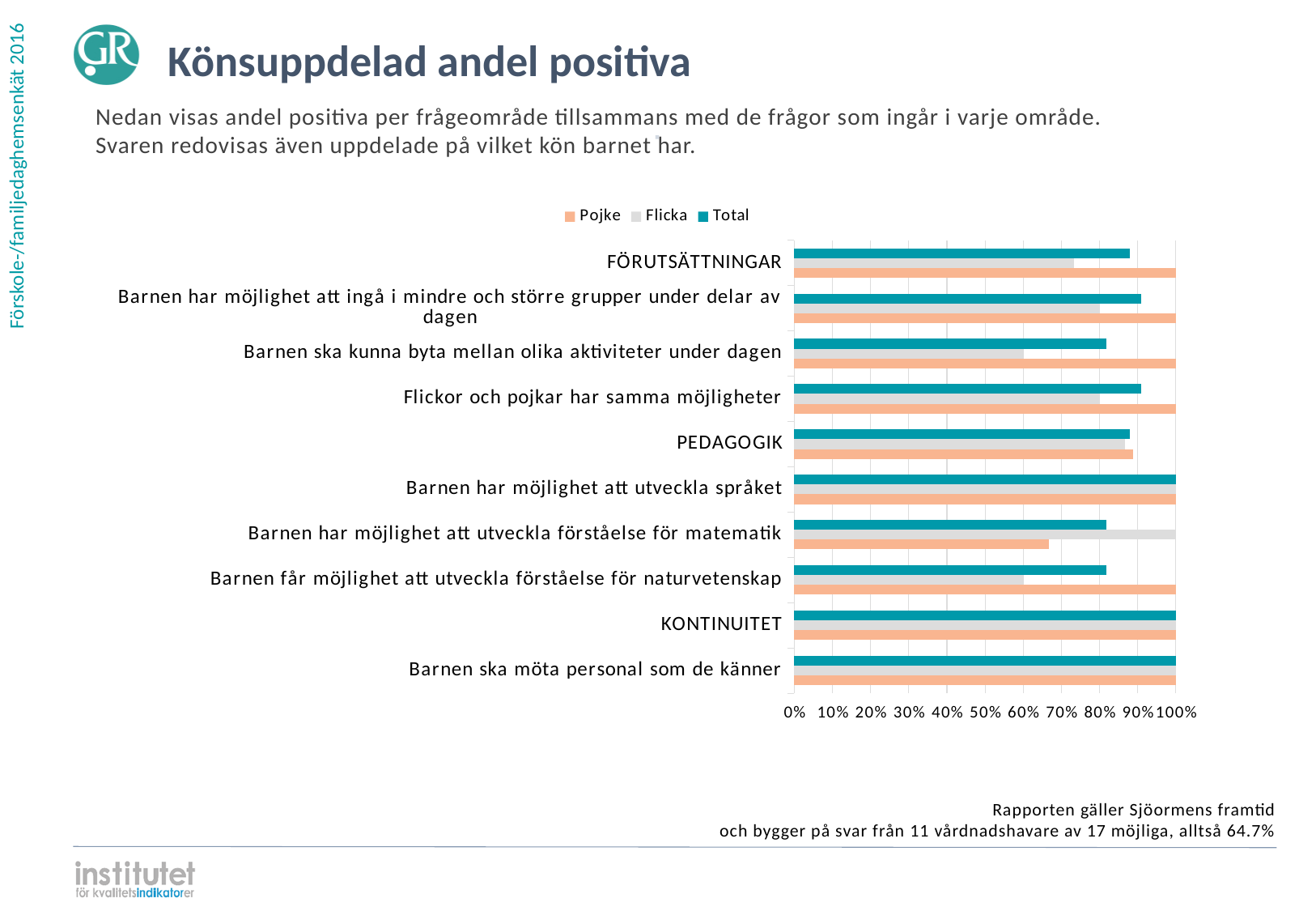
What is the Flicka value for 'Barnen har möjlighet att utveckla förståelse för matematik'? 100% How many categories are shown on the vertical axis of the chart? 10 What is the title of the slide's chart section? Könsuppdelad andel positiva What is the Pojke value for KONTINUITET? 100% What is the Total value for 'Barnen ska möta personal som de känner'? 100% How many series does the legend list? 3 Is the Total value for FÖRUTSÄTTNINGAR greater or less than 90%? less What kind of chart is shown on the slide? bar chart Is the Flicka value for 'Barnen får möjlighet att utveckla förståelse för naturvetenskap' greater or less than 70%? less For 'Barnen har möjlighet att utveckla förståelse för matematik', which is larger: the Pojke value or the Flicka value? Flicka For 'Barnen får möjlighet att utveckla förståelse för naturvetenskap', which is larger: the Pojke value or the Flicka value? Pojke Is the Pojke value for 'Barnen har möjlighet att utveckla förståelse för matematik' greater or less than 70%? less